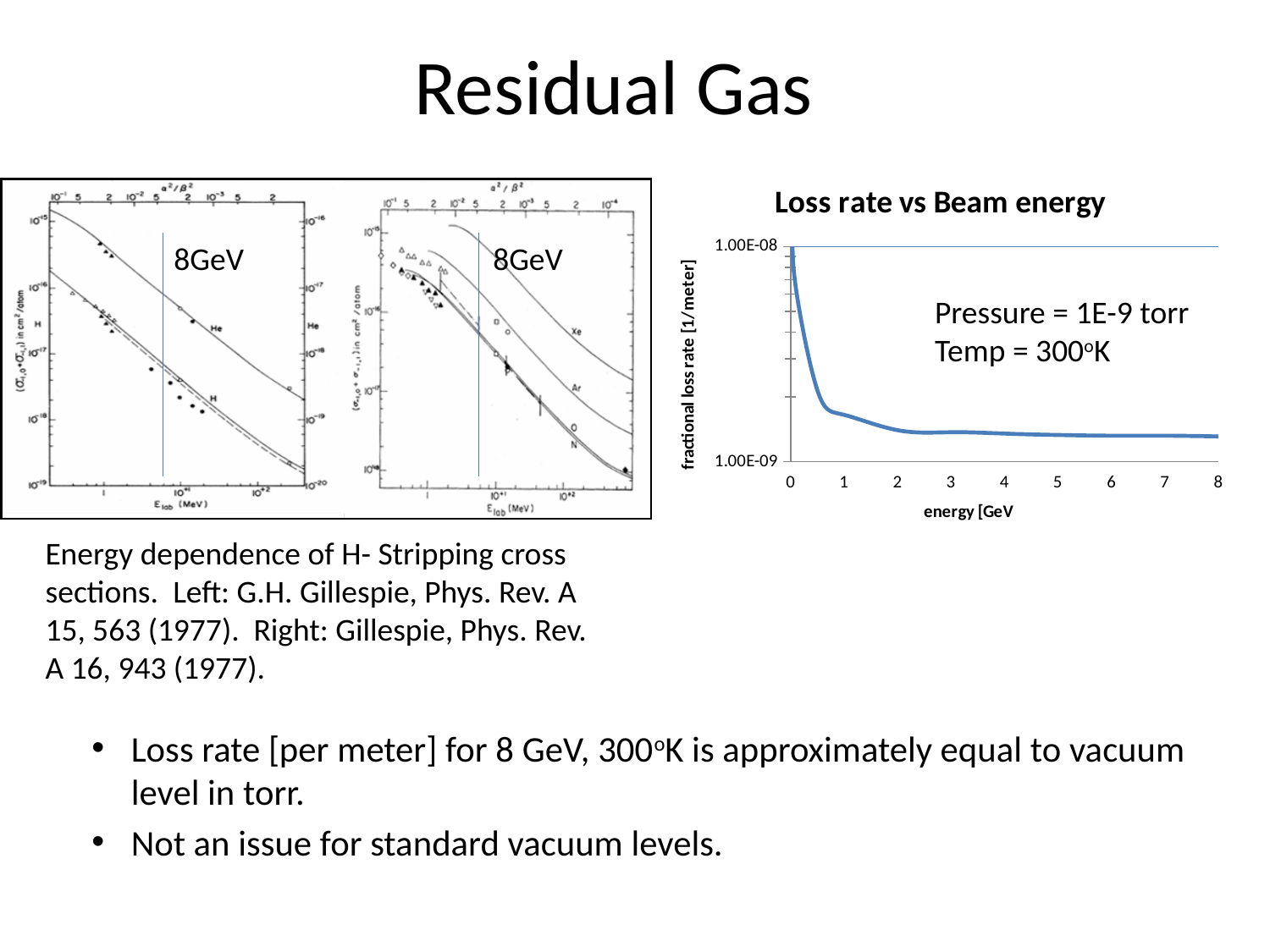
In the 'Loss rate vs Beam energy' chart, which is larger: the loss rate at 0 GeV or at 8 GeV? 0 GeV In the 'Loss rate vs Beam energy' chart, what is the highest value shown on the y axis? 1.00E-08 In the 'Loss rate vs Beam energy' chart, which is larger: the loss rate at 1 GeV or at 5 GeV? 1 GeV In the 'Loss rate vs Beam energy' chart, what kind of chart is shown? line chart In the 'Loss rate vs Beam energy' chart, at which energy is the fractional loss rate highest? 0 GeV In the 'Loss rate vs Beam energy' chart, how many tick labels are shown on the x axis? 9 In the 'Loss rate vs Beam energy' chart, what is the label of the x axis? energy [GeV In the 'Loss rate vs Beam energy' chart, what pressure is stated in the annotation? 1E-9 torr In the 'Loss rate vs Beam energy' chart, is the fractional loss rate at 8 GeV greater or less than 1.00E-09? greater In the 'Loss rate vs Beam energy' chart, is the fractional loss rate at 4 GeV greater or less than 1.00E-08? less In the 'Loss rate vs Beam energy' chart, does the fractional loss rate rise or fall as energy increases from 0 to 8 GeV? fall